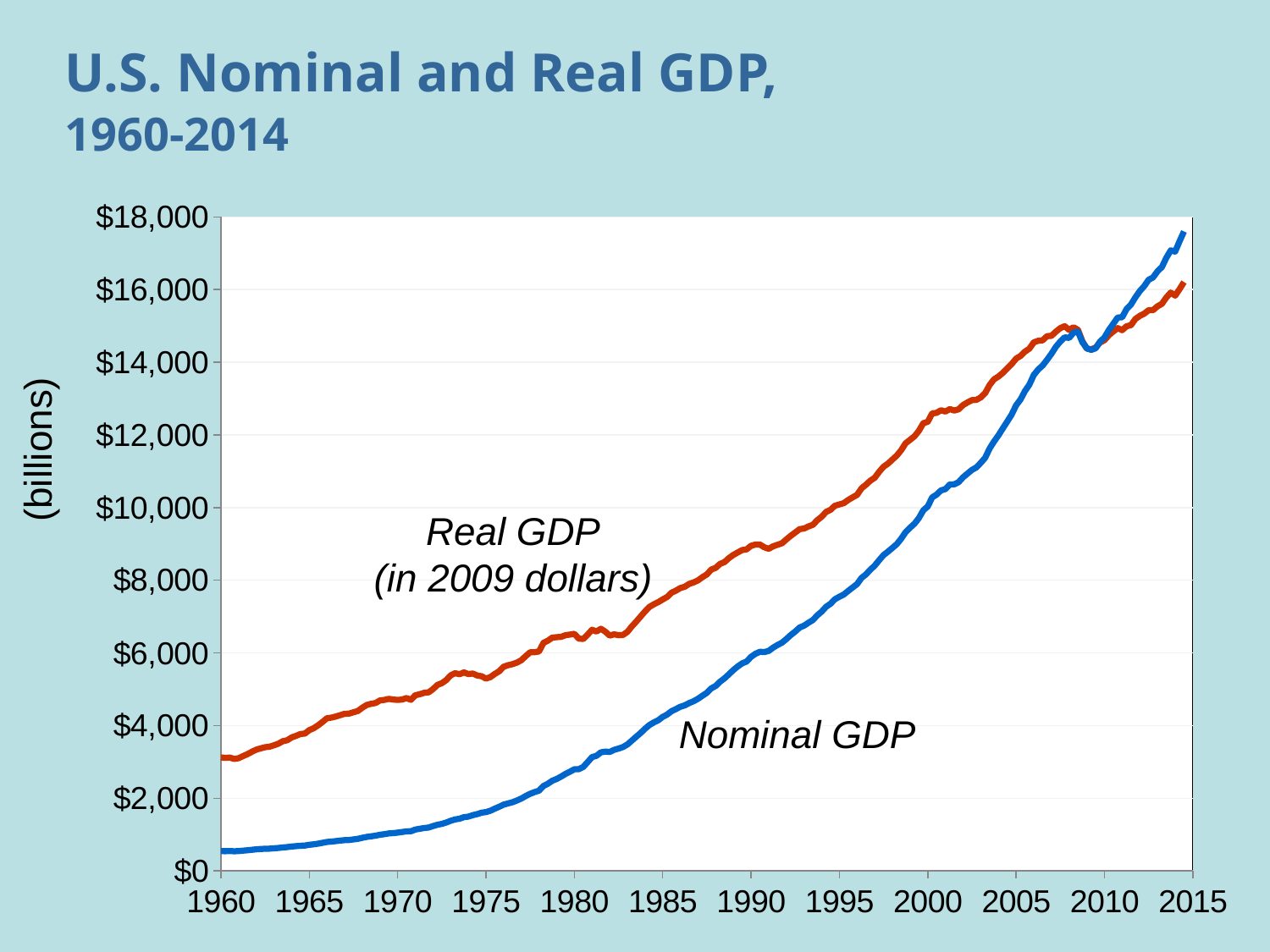
In 2014, which is larger, Real GDP or Nominal GDP? Nominal GDP Is the value for Nominal GDP in 1960 greater or less than $2,000? less Is the value for Real GDP in 1960 greater or less than $2,000? greater Is the value for Nominal GDP in 2014 greater or less than $16,000? greater In 1990, which is larger, Real GDP or Nominal GDP? Real GDP What is the title of the chart on the slide? U.S. Nominal and Real GDP, 1960-2014 What kind of chart is shown on the slide? Line chart What colour is the Nominal GDP line? Blue How many data series are plotted on the chart? 2 Does Nominal GDP rise or fall from 1960 to 2014? Rise